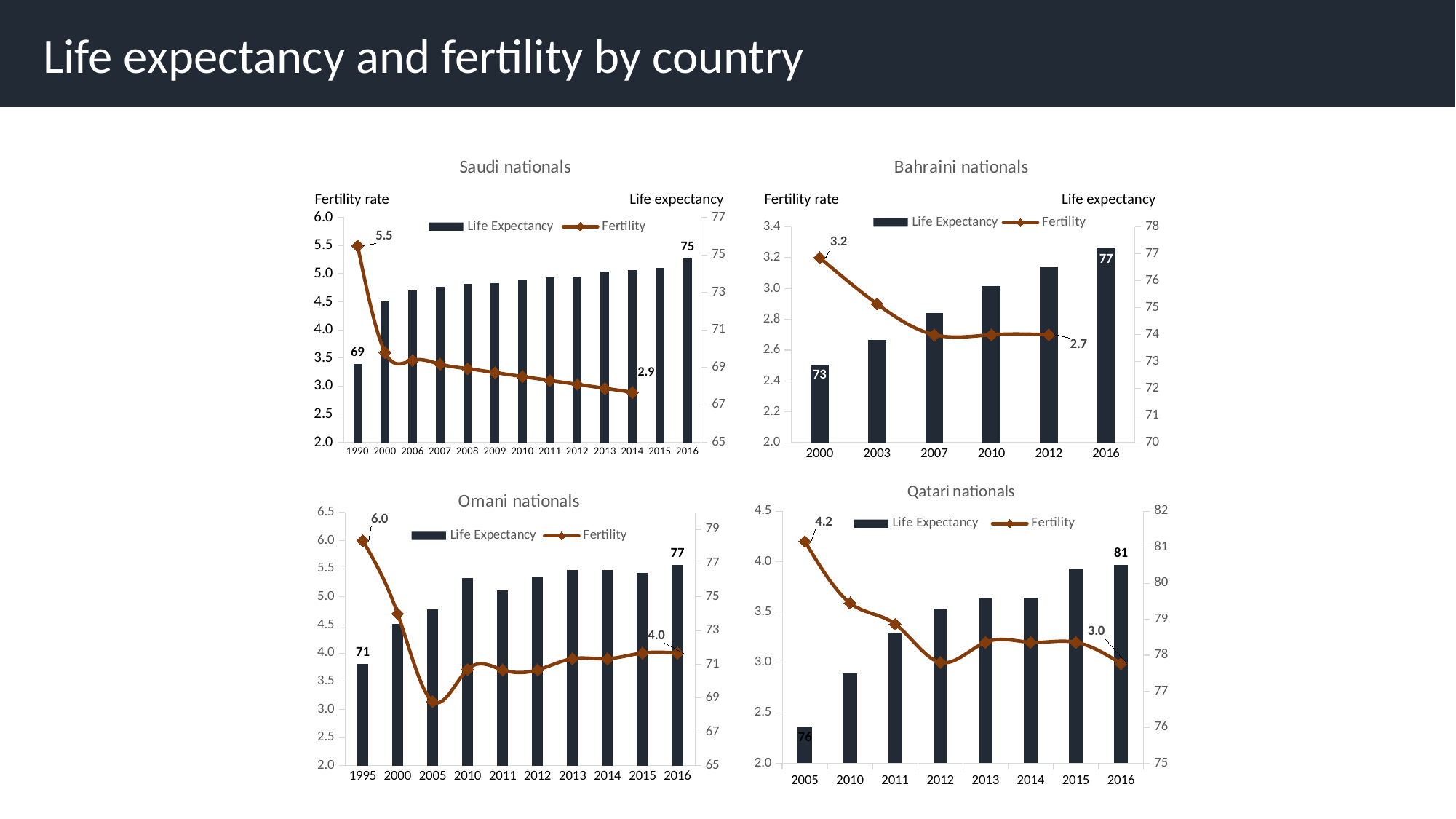
In the Qatari nationals chart, is the life expectancy for 2012 greater or less than 78? greater In the Omani nationals chart, does the life expectancy series generally rise or fall from 1995 to 2016? rise In the Bahraini nationals chart, what is the fertility rate labelled for 2012? 2.7 In the Qatari nationals chart, what is the life expectancy labelled for 2016? 81 In the Saudi nationals chart, by how much did life expectancy rise from the 1990 label (69) to the 2016 label (75)? 6 How many series does the legend list in the Qatari nationals chart? 2 In the Omani nationals chart, what is the fertility rate labelled for 1995? 6.0 In the Bahraini nationals chart, what is the difference between the fertility labels for 2000 (3.2) and 2012 (2.7)? 0.5 In the Saudi nationals chart, what is the life expectancy labelled for 2016? 75 In the Saudi nationals chart, which is larger, the fertility rate in 1990 or in 2014? 1990 In the Bahraini nationals chart, how many years are shown on the x axis? 6 In the Saudi nationals chart, what is the fertility rate labelled for 1990? 5.5